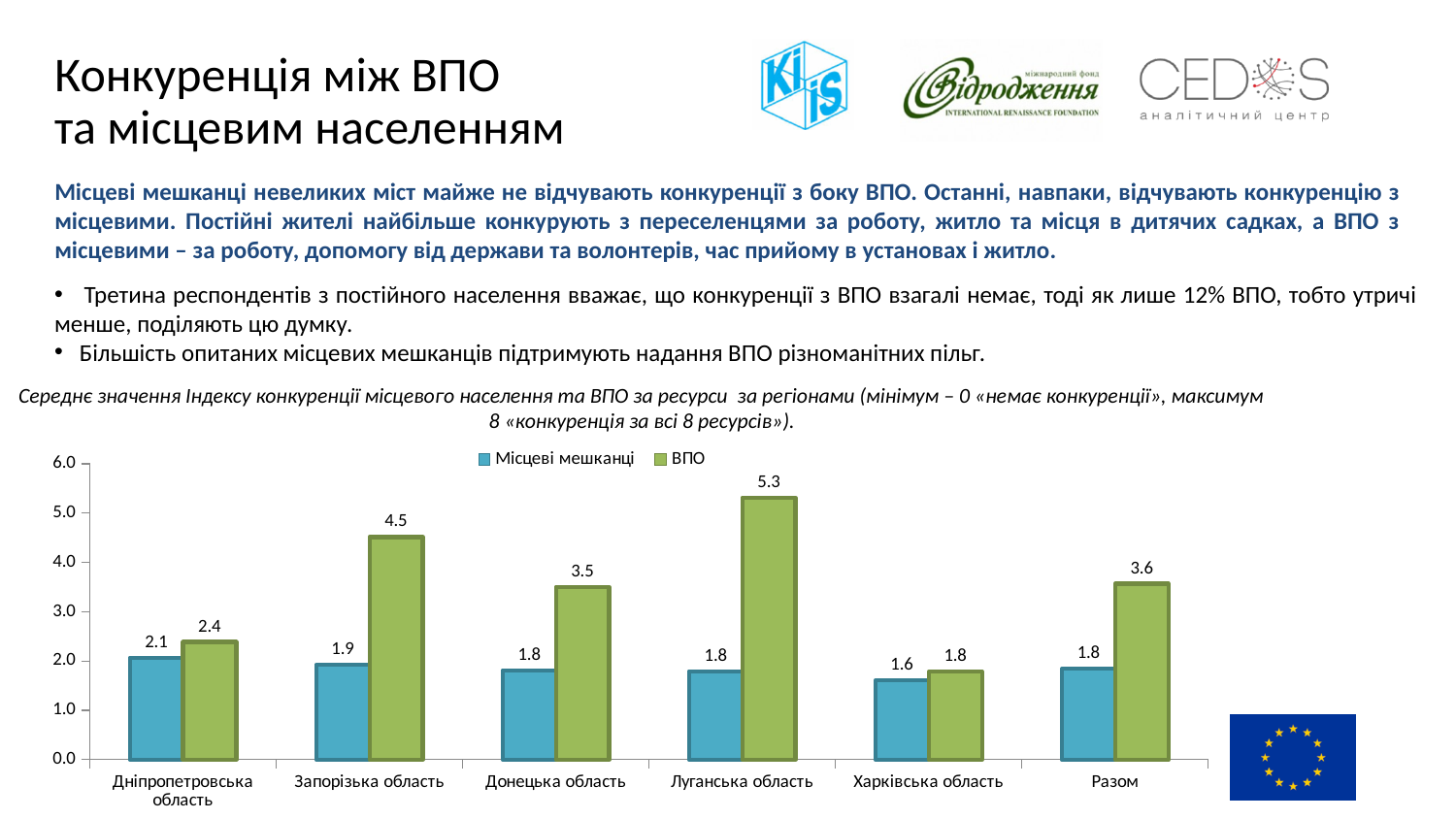
Is the value for ВПО in Луганська область greater or less than 5.0? greater Which colour represents the ВПО series in the chart? Green How many categories are shown on the x axis? 6 Which category has the highest value for ВПО? Луганська область How many series does the legend list? 2 Which is larger in Разом: the value for ВПО or for Місцеві мешканці? ВПО What type of chart is shown on the slide? Bar chart Which category has the lowest value for Місцеві мешканці? Харківська область What is the value for Місцеві мешканці in Дніпропетровська область? 2.1 What is the value for ВПО in Луганська область? 5.3 What is the value for ВПО in Запорізька область? 4.5 What is the difference between the ВПО and Місцеві мешканці values in Донецька область? 1.7